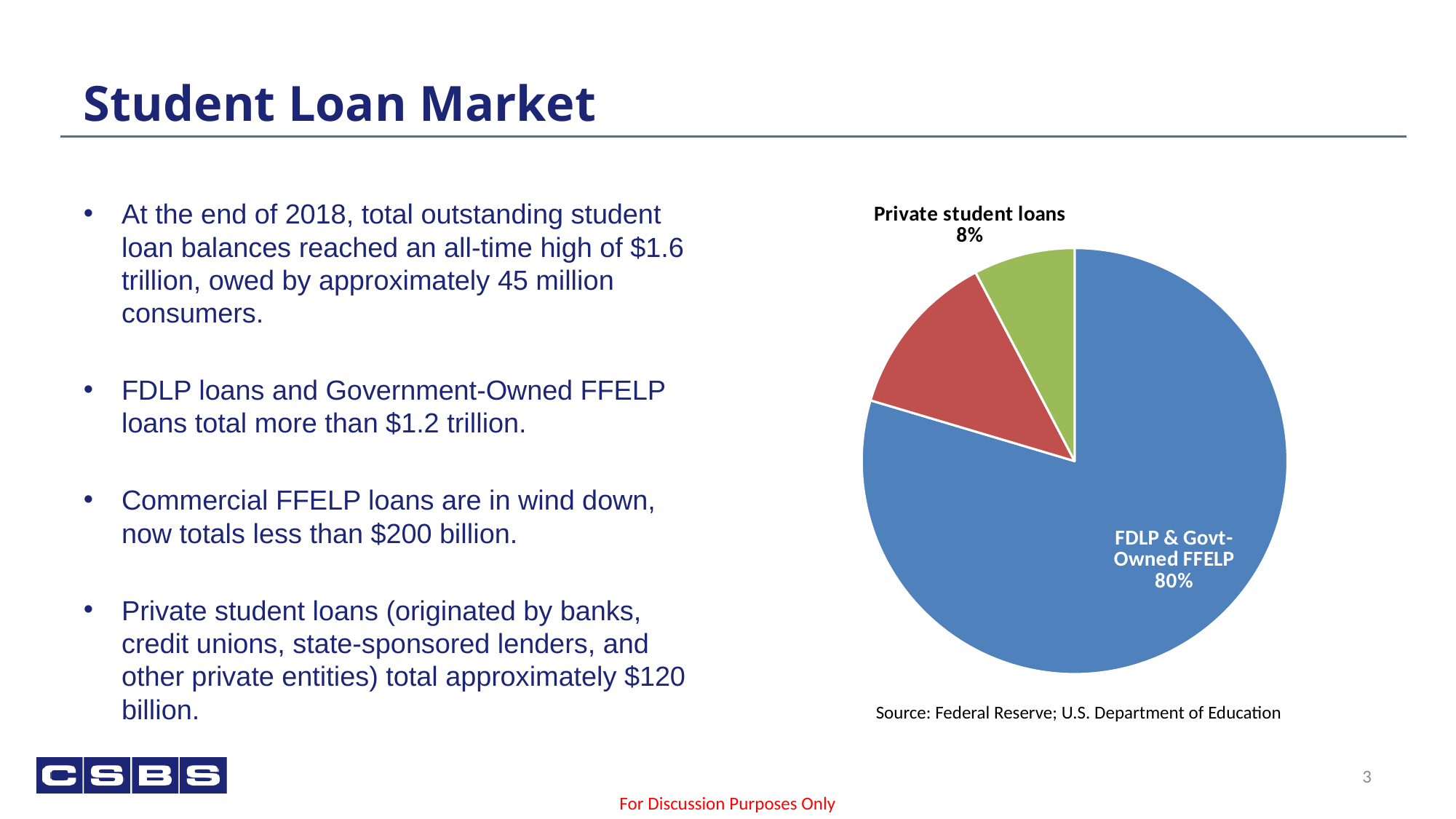
What share of the pie does the Private student loans slice represent? 8% What kind of chart is shown on the slide? pie chart What source is cited beneath the pie chart? Federal Reserve; U.S. Department of Education By how many percentage points does the FDLP & Govt-Owned FFELP share exceed the Private student loans share? 72 percentage points Which labeled slice of the pie chart is the largest? FDLP & Govt-Owned FFELP What share of the pie does the FDLP & Govt-Owned FFELP slice represent? 80% Which labeled slice of the pie chart is the smallest? Private student loans What colour is the FDLP & Govt-Owned FFELP slice in the pie chart? blue Which is larger in the pie chart: FDLP & Govt-Owned FFELP or Private student loans? FDLP & Govt-Owned FFELP How many slices does the pie chart have? 3